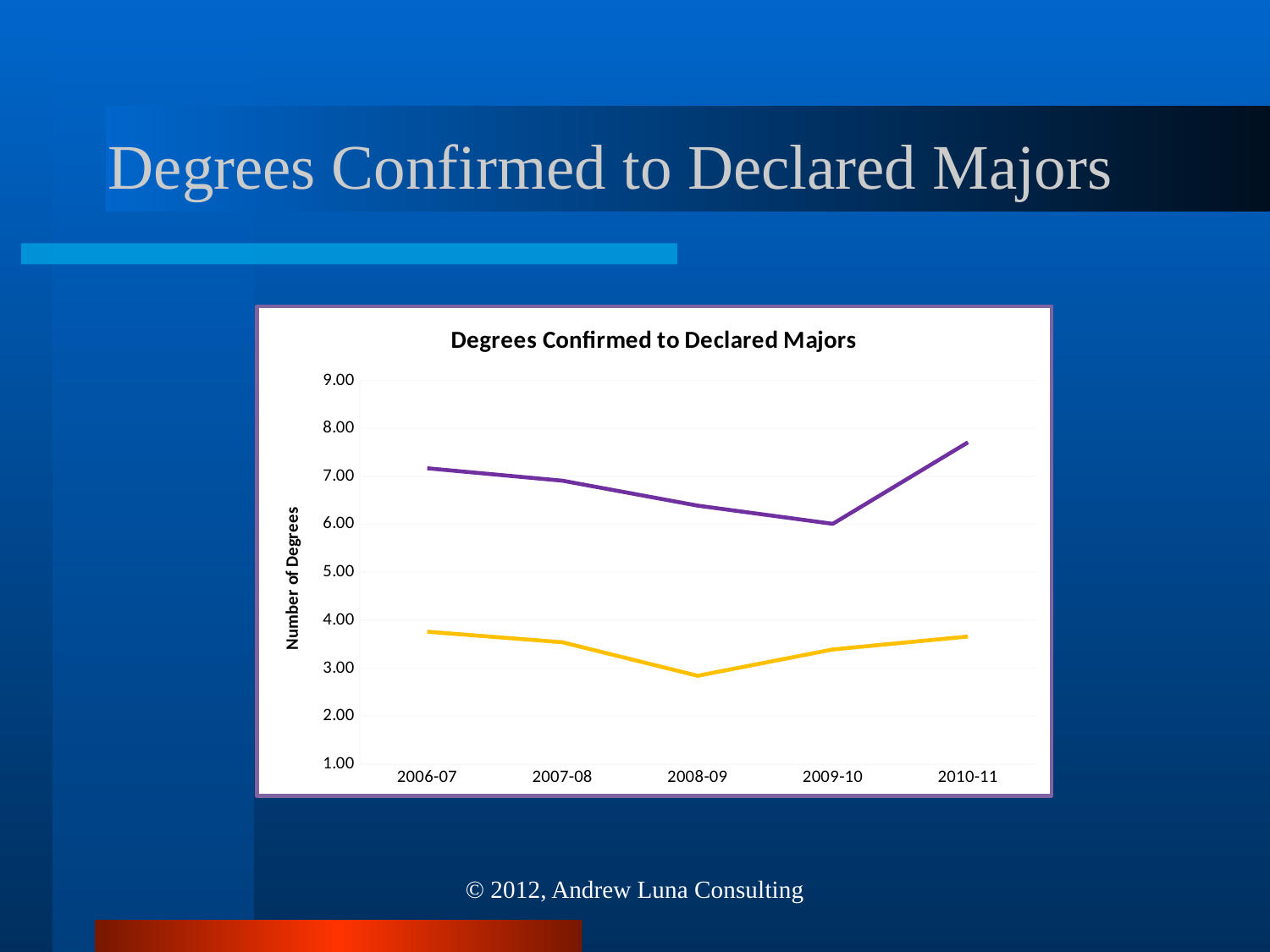
What is the label on the vertical axis of the chart? Number of Degrees Which line has the higher value in 2008-09, the purple line or the yellow line? the purple line In which year does the yellow line reach its lowest value? 2008-09 In which year does the purple line reach its highest value? 2010-11 How many academic years are shown on the x axis of the chart? 5 What is the title of the chart? Degrees Confirmed to Declared Majors Is the value of the purple line for 2010-11 greater or less than 7.00? greater In which year does the purple line reach its lowest value? 2009-10 Does the purple line rise or fall from 2006-07 to 2009-10? fall Is the value of the yellow line for 2006-07 greater or less than 3.00? greater What kind of chart is shown on the slide? line chart Is the value of the yellow line for 2009-10 greater or less than 4.00? less